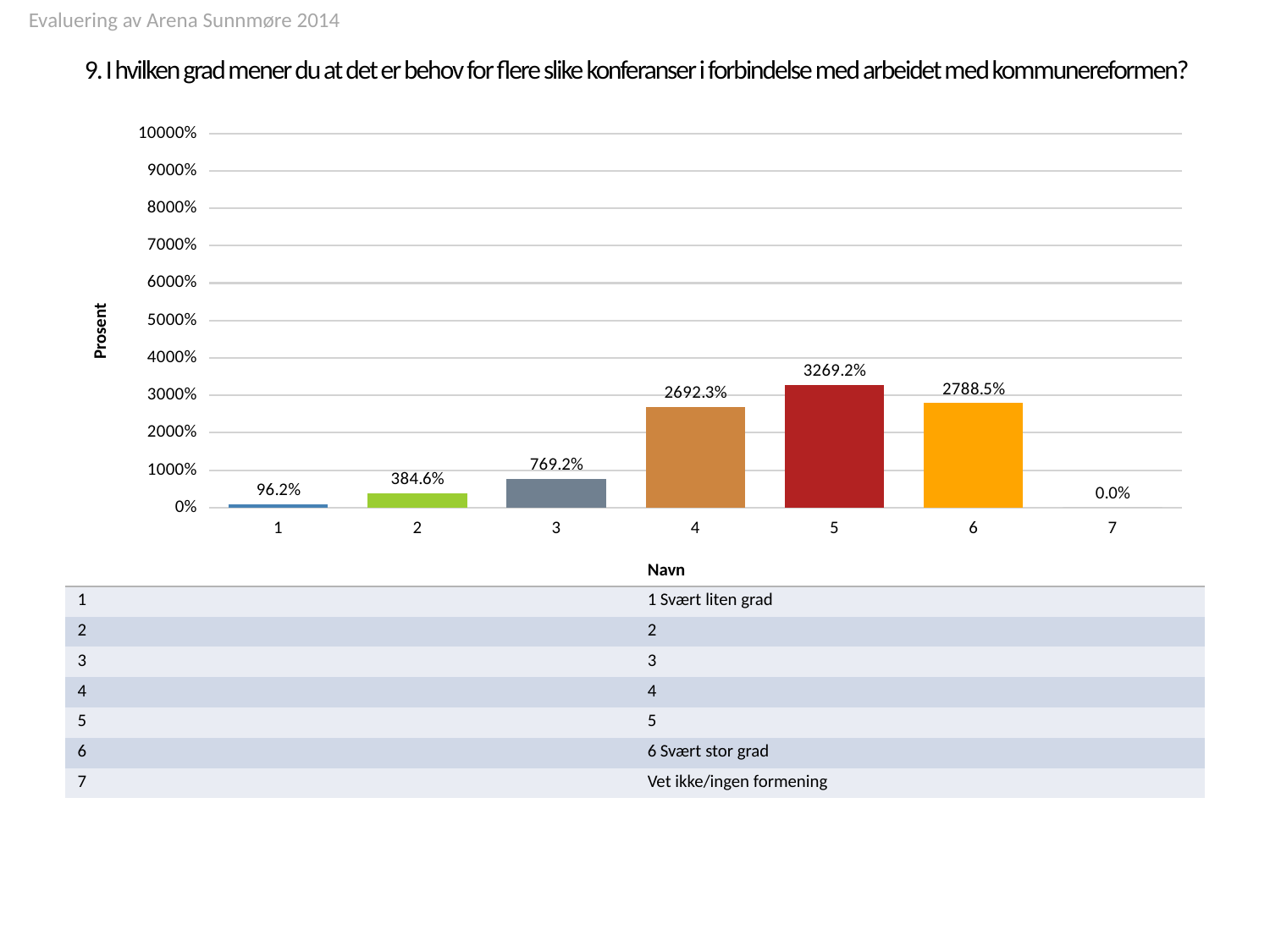
Which category has the highest value? 5 What is the difference between the values for category 3 and category 2? 384.6% What is the value for category 5? 3269.2% Which is larger, the value for category 4 or the value for category 6? 6 What kind of chart is shown on the slide? bar chart What is the difference between the values for category 5 and category 4? 576.9% Is the value for category 5 greater or less than 3000%? greater Which category has the lowest value? 7 What is the value for category 1? 96.2% What is the value for category 7? 0.0% What is the label of the y axis? Prosent How many categories are shown on the x axis? 7